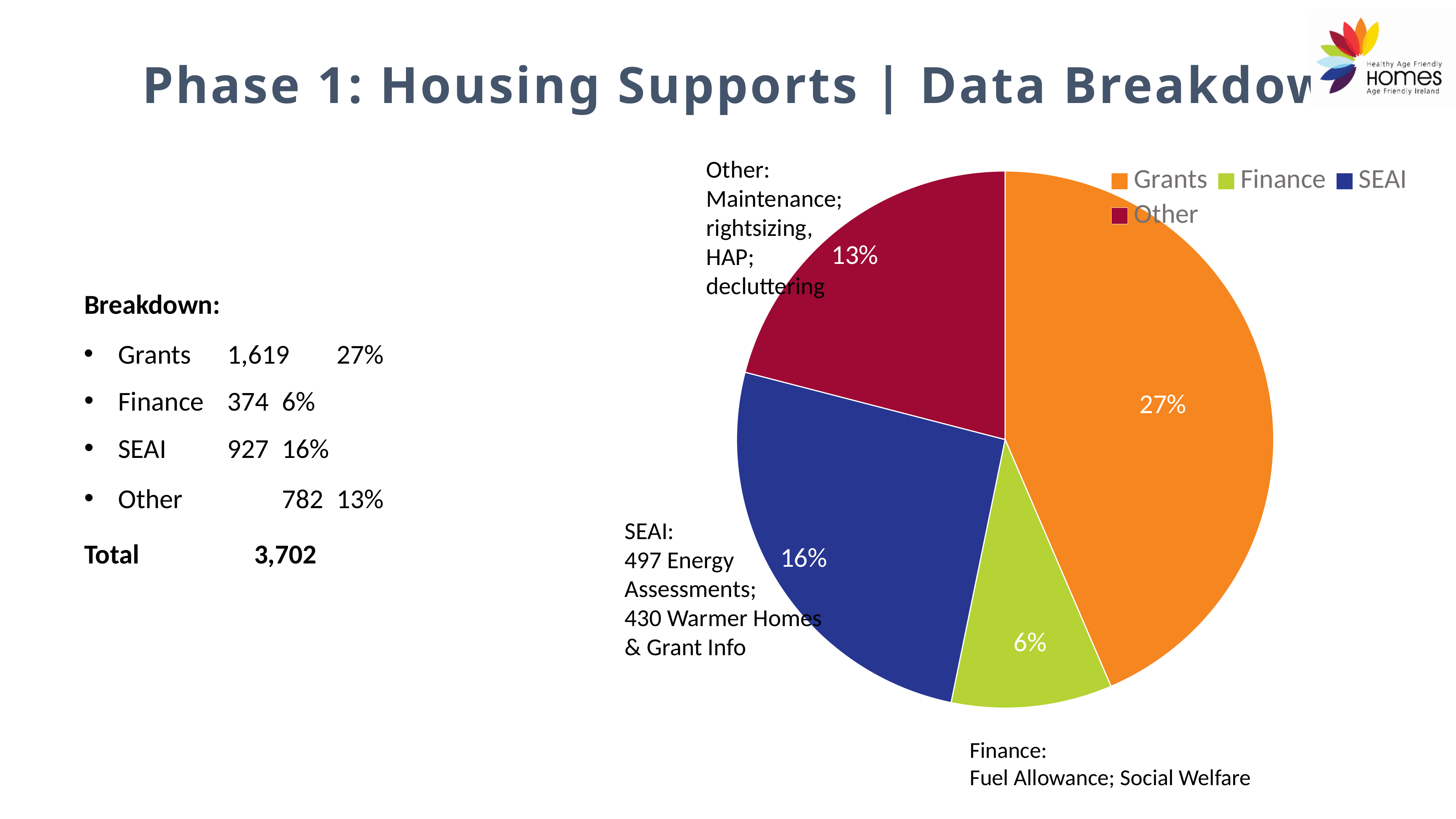
How many slices does the pie chart have? 4 What is the difference in percentage points between the SEAI and Finance labels on the pie chart? 10 What colour is the Grants slice in the pie chart? orange Which slice of the pie chart is the largest? Grants Which slice is larger in the pie chart, SEAI or Other? SEAI How many entries does the pie chart legend list? 4 Which slice of the pie chart is the smallest? Finance What percentage label is shown on the SEAI slice of the pie chart? 16% What percentage label is shown on the Other slice of the pie chart? 13% What percentage label is shown on the Grants slice of the pie chart? 27% What kind of chart is shown on the slide? pie chart What percentage label is shown on the Finance slice of the pie chart? 6%